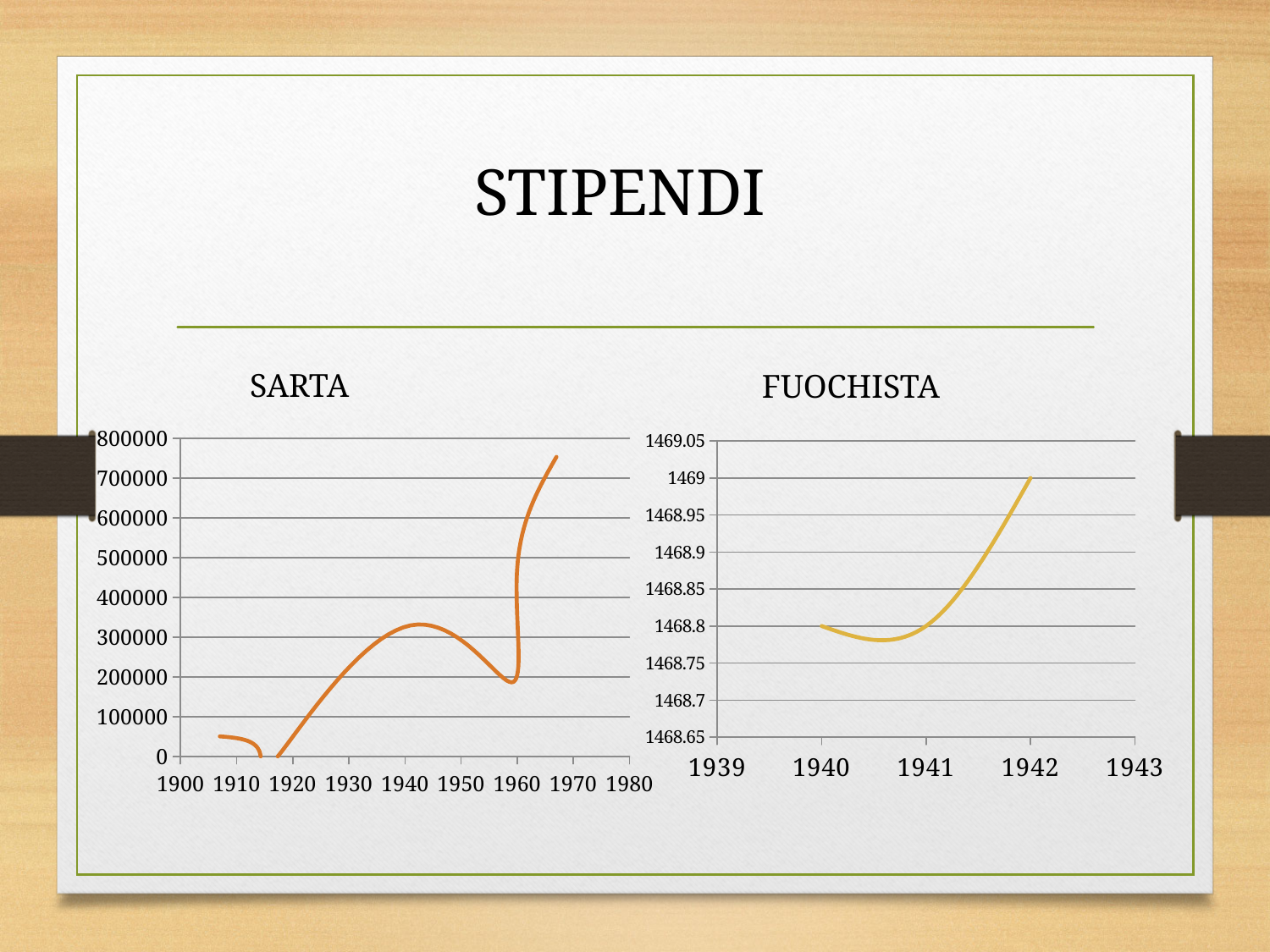
In the SARTA chart, is the value for 1940 greater or less than 200000? greater In the FUOCHISTA chart, which is larger, the value for 1940 or the value for 1942? 1942 In the FUOCHISTA chart, does the line rise or fall between 1941 and 1942? rise What kind of chart is the SARTA chart? line chart In the FUOCHISTA chart, is the value for 1942 greater or less than 1468.9? greater What is the title of the slide containing the two charts? STIPENDI In the FUOCHISTA chart, what is the value for 1942? 1469 In the FUOCHISTA chart, what is the value for 1940? 1468.8 What kind of chart is the FUOCHISTA chart? line chart In the SARTA chart, is the value for 1910 greater or less than 100000? less